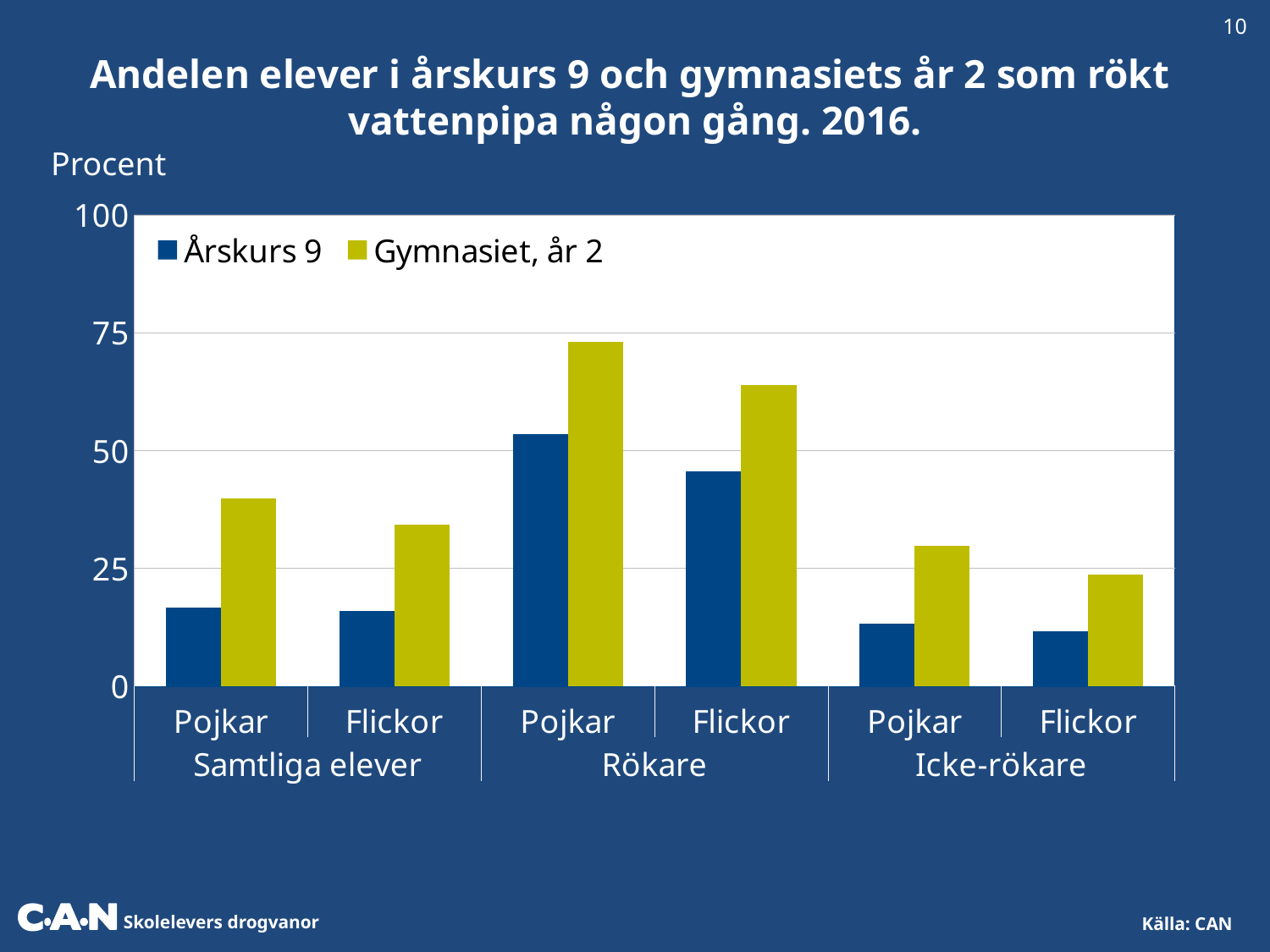
How many bar groups (categories) are shown along the x axis? 6 For Pojkar in the Samtliga elever group, which series has the larger value: Årskurs 9 or Gymnasiet, år 2? Gymnasiet, år 2 Which category has the lowest value for Gymnasiet, år 2? Flickor, Icke-rökare For Årskurs 9, which is larger: the value for Pojkar in the Rökare group or Pojkar in the Icke-rökare group? Pojkar in the Rökare group What label is shown above the y axis of the chart? Procent Which category has the highest value for Gymnasiet, år 2? Pojkar, Rökare What kind of chart is shown on the slide? Bar chart Is the value for Gymnasiet, år 2 among Pojkar in the Samtliga elever group greater or less than 25? greater Is the value for Årskurs 9 among Flickor in the Icke-rökare group greater or less than 25? less Is the value for Årskurs 9 among Flickor in the Rökare group greater or less than 50? less How many series does the legend list? 2